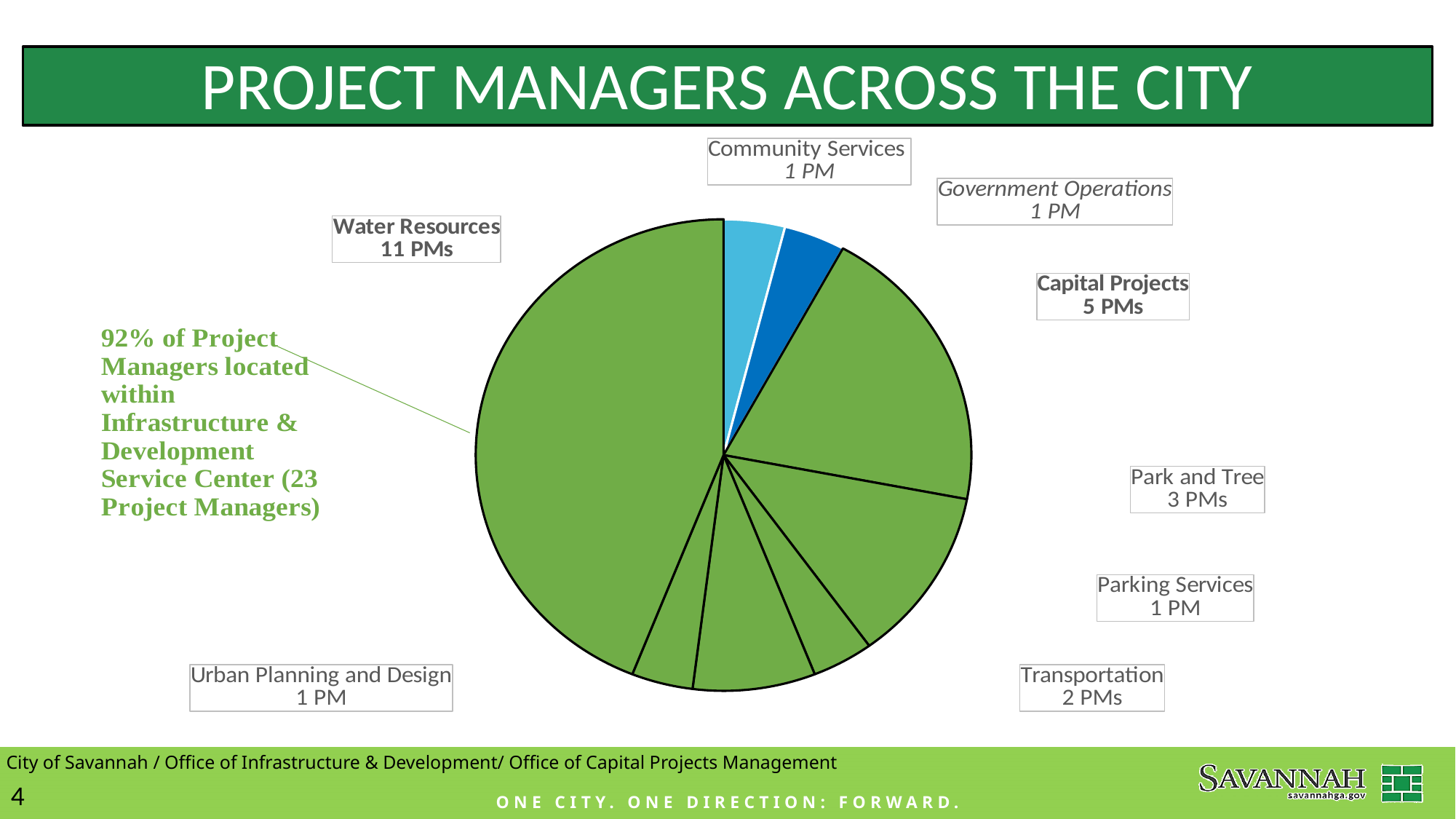
How many project managers does Water Resources have? 11 PMs How many more project managers does Water Resources have than Capital Projects? 6 How many departments are shown in the pie chart? 8 How many project managers does Capital Projects have? 5 PMs What is the total number of project managers across all slices of the pie chart? 25 How many project managers does Park and Tree have? 3 PMs Which has more project managers, Park and Tree or Transportation? Park and Tree What kind of chart is shown on the slide? Pie chart Which department has the most project managers? Water Resources What is the title of the slide containing the pie chart? PROJECT MANAGERS ACROSS THE CITY How many project managers does Transportation have? 2 PMs What share of all project managers does Water Resources represent? 44%